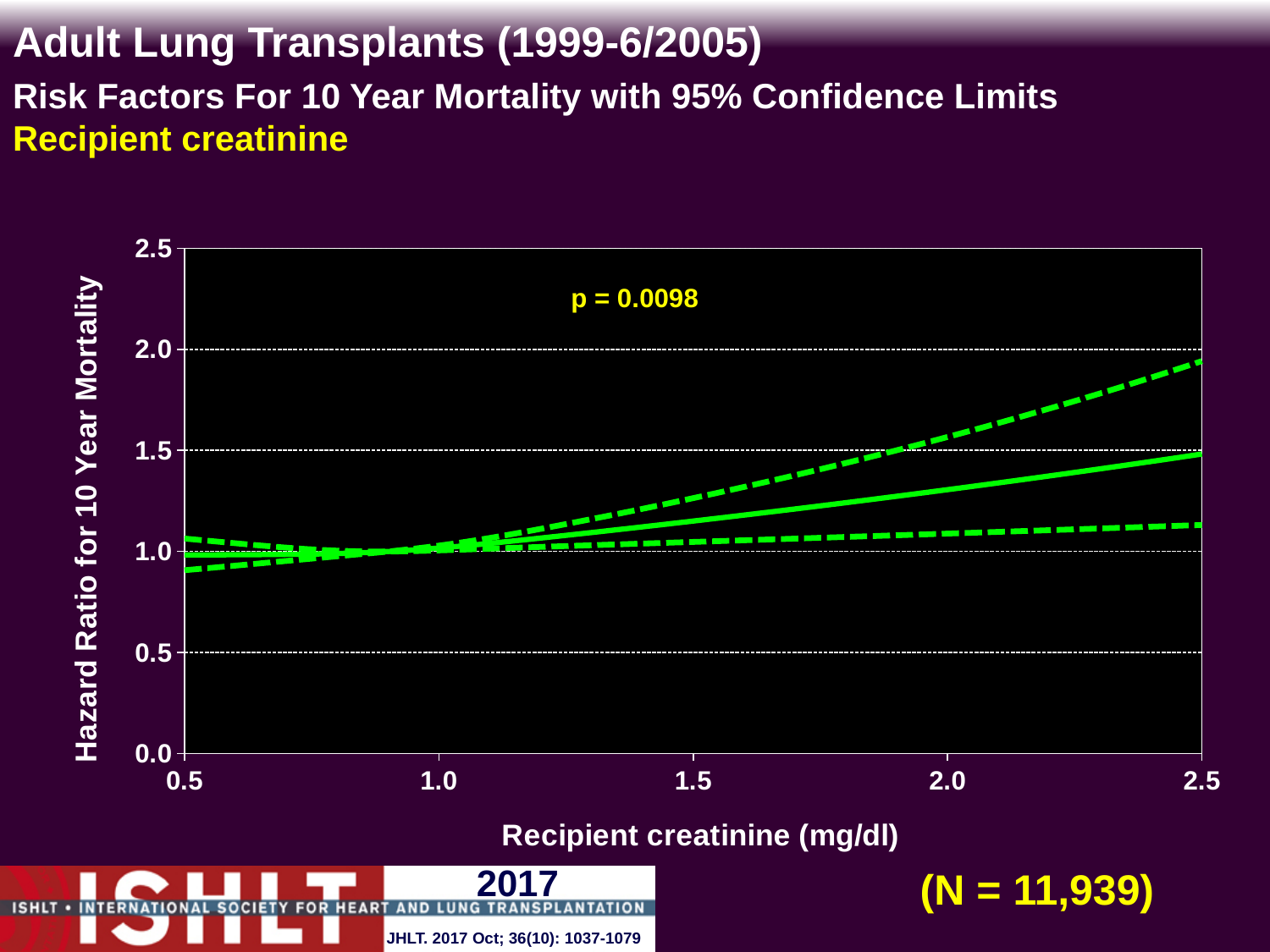
What is the highest value shown on the y axis? 2.5 Is the hazard ratio (solid line) at a recipient creatinine of 2.0 mg/dl greater or less than 1.5? less Is the lower confidence limit (lower dashed line) at a recipient creatinine of 0.5 mg/dl greater or less than 1.0? less What is the sample size (N) shown on the slide? N = 11,939 Is the upper confidence limit (upper dashed line) at a recipient creatinine of 2.5 mg/dl greater or less than 1.5? greater Does the hazard ratio (solid line) rise or fall as recipient creatinine increases from 1.0 to 2.5 mg/dl? rise How many lines are plotted on the chart? 3 What kind of chart is shown on the slide? line chart What is the p-value printed on the chart? p = 0.0098